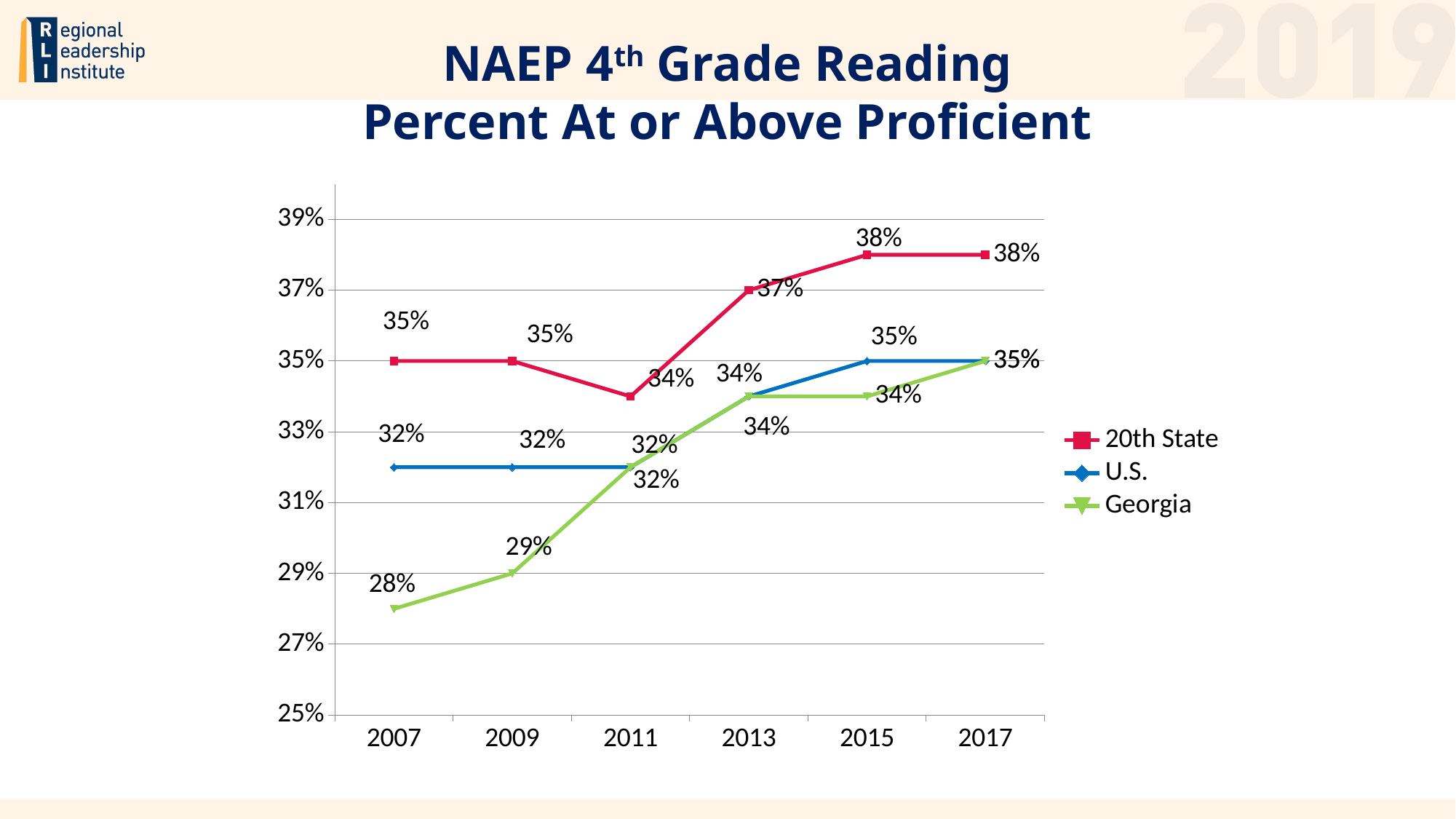
In which year is the Georgia value lowest? 2007 What kind of chart is shown on the slide? line chart What is the value for Georgia in 2007? 28% Which series has the highest value in 2017? 20th State Which is larger in 2009, the U.S. value or the Georgia value? U.S. What is the value for the U.S. in 2013? 34% How many years are shown on the x axis? 6 How many series does the legend list? 3 Which series is drawn in green? Georgia What is the difference between the 20th State and Georgia values in 2007? 7% Does the Georgia line generally rise or fall from 2007 to 2017? rise What is the value for the 20th State in 2015? 38%